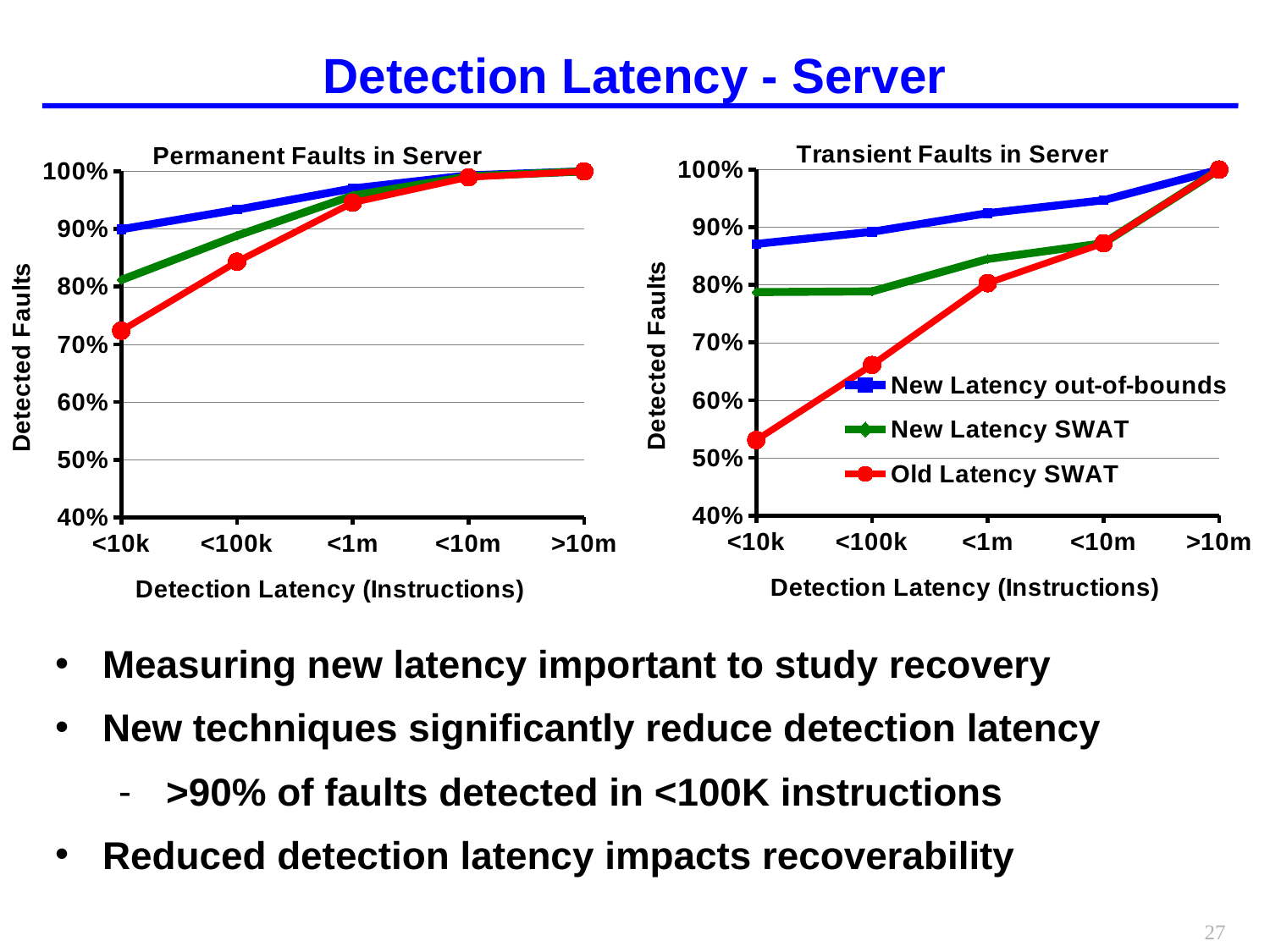
In the 'Permanent Faults in Server' chart, how many detection latency categories are shown on the x axis? 5 In the 'Permanent Faults in Server' chart, is the value for Old Latency SWAT at <10k greater or less than 80%? less In the 'Transient Faults in Server' chart, is the value for New Latency out-of-bounds at <10k greater or less than 80%? greater What kind of chart is the 'Permanent Faults in Server' chart? line chart In the 'Transient Faults in Server' chart, what is the value for Old Latency SWAT at >10m? 100% What is the x-axis title of the 'Transient Faults in Server' chart? Detection Latency (Instructions) In the 'Permanent Faults in Server' chart, at <10k, which is higher: New Latency out-of-bounds or Old Latency SWAT? New Latency out-of-bounds In the 'Transient Faults in Server' chart, is the value for Old Latency SWAT at <10k greater or less than 60%? less In the 'Transient Faults in Server' chart, how many series does the legend list? 3 In the 'Transient Faults in Server' chart, does the Old Latency SWAT line rise or fall from <10k to >10m? rise In the 'Transient Faults in Server' chart, which series has the lowest value at <10k? Old Latency SWAT What is the y-axis title of the 'Permanent Faults in Server' chart? Detected Faults